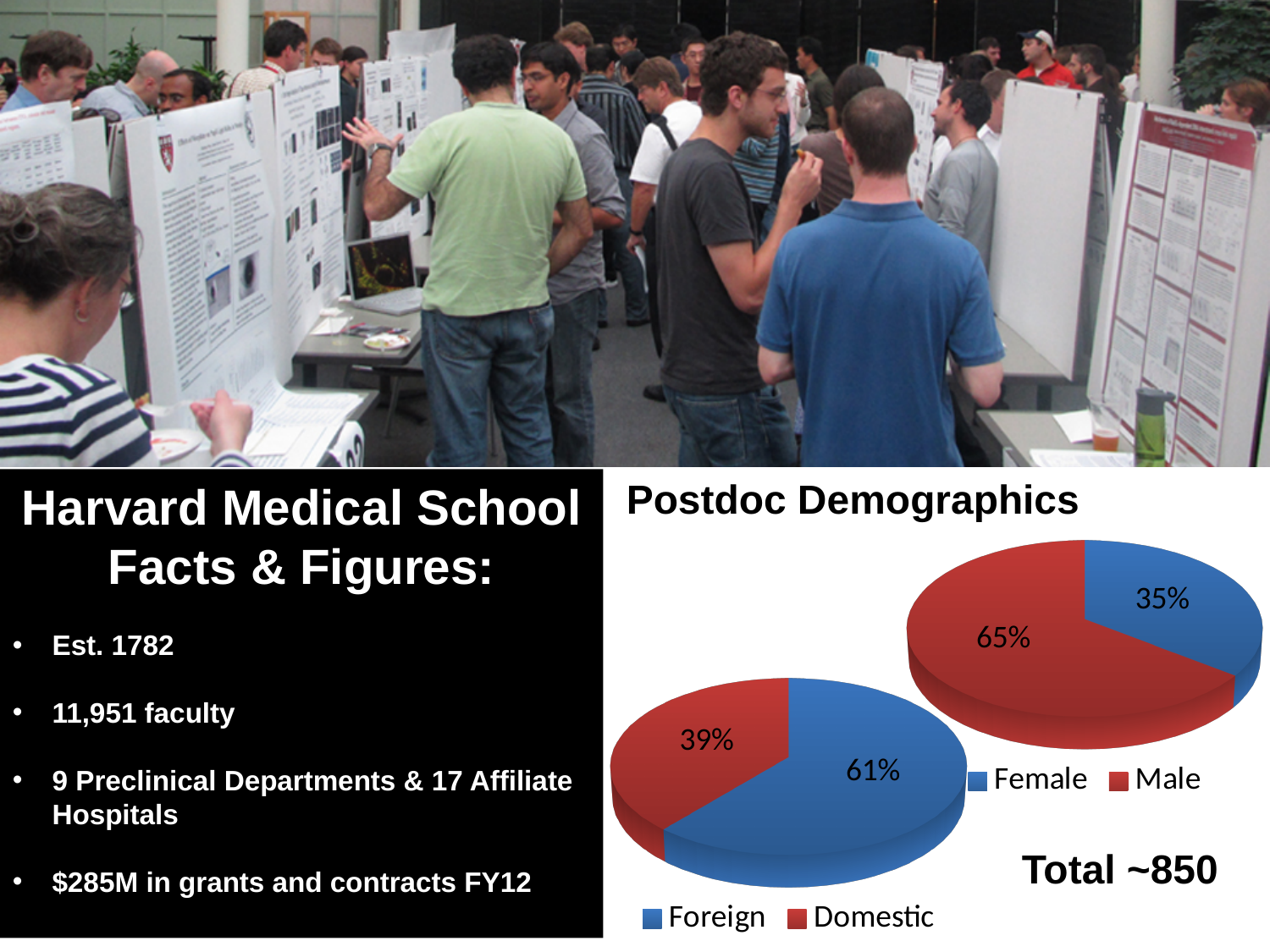
What colour represents Female in the Female/Male pie chart? Blue In the Foreign/Domestic pie chart under Postdoc Demographics, what share is Domestic? 39% In the Foreign/Domestic pie chart under Postdoc Demographics, what share is Foreign? 61% Which is larger: the Foreign share in the Foreign/Domestic pie chart or the Male share in the Female/Male pie chart? Male What type of chart is used to show the Postdoc Demographics? Pie chart In the Female/Male pie chart, what is the difference in percentage points between Male and Female? 30 In the Foreign/Domestic pie chart, what is the difference in percentage points between Foreign and Domestic? 22 In the Female/Male pie chart under Postdoc Demographics, what share is Male? 65% In the Foreign/Domestic pie chart, which category has the smaller share? Domestic In the Female/Male pie chart, which category has the larger share? Male In the Female/Male pie chart under Postdoc Demographics, what share is Female? 35% How many slices does the Foreign/Domestic pie chart have? 2